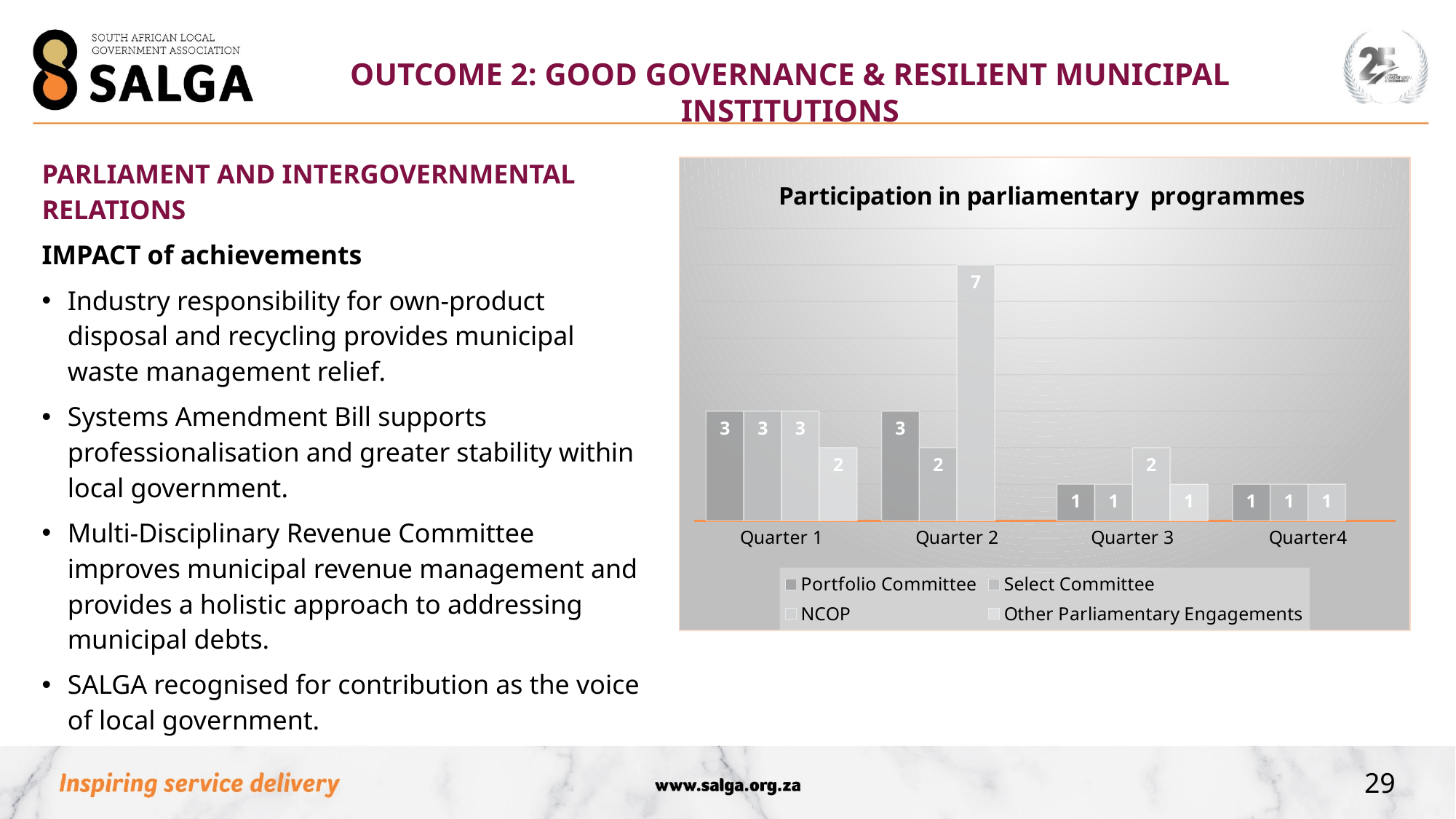
What kind of chart is shown on the slide? Bar chart What is the value for Portfolio Committee in Quarter 2? 3 How many series does the chart legend list? 4 What is the highest value shown in the chart, and in which quarter does it occur? 7, Quarter 2 Which series is listed first in the chart legend? Portfolio Committee What is the value for NCOP in Quarter 2? 7 What is the difference between the NCOP value in Quarter 2 and the Portfolio Committee value in Quarter 2? 4 What is the value for Portfolio Committee in Quarter 1? 3 How many quarters are shown on the x axis of the chart? 4 What is the title of the chart? Participation in parliamentary programmes Which is larger: the Portfolio Committee value in Quarter 1 or the Portfolio Committee value in Quarter 3? Quarter 1 What is the value for Other Parliamentary Engagements in Quarter 1? 2